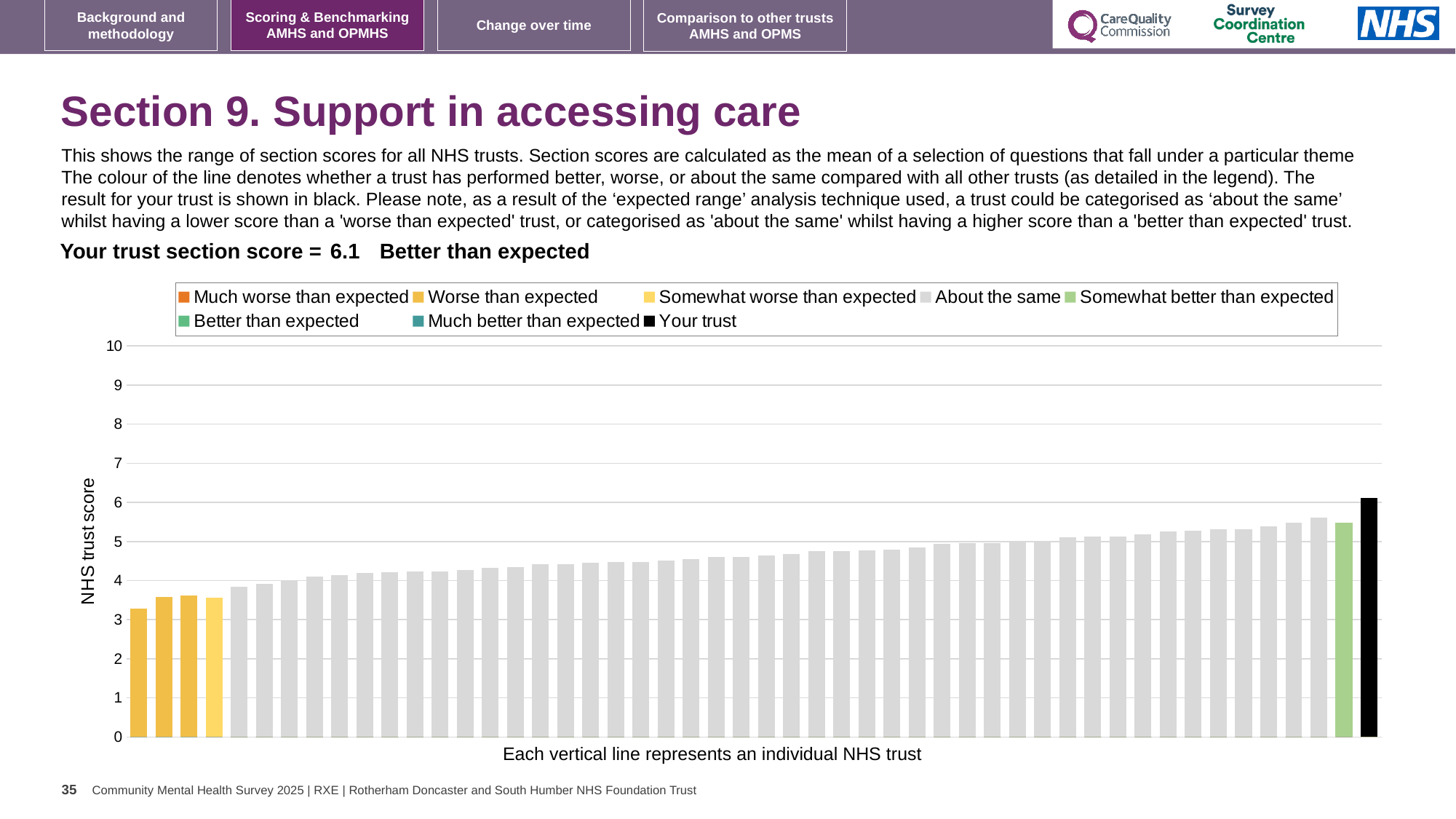
Do the bar values rise or fall from left to right along the x axis? rise How is your trust's section score categorised? Better than expected How many bars are coloured as 'Worse than expected'? 3 How many entries does the legend list? 8 Which bar is the highest in the chart? Your trust What is the section score for your trust? 6.1 What is the highest value shown on the y axis? 10 What kind of chart is shown on the slide? bar chart Is the value for the leftmost bar greater or less than 4? less What is the label on the y axis? NHS trust score Is the value for the black 'Your trust' bar greater or less than 5? greater How many bars are coloured as 'Somewhat better than expected'? 1